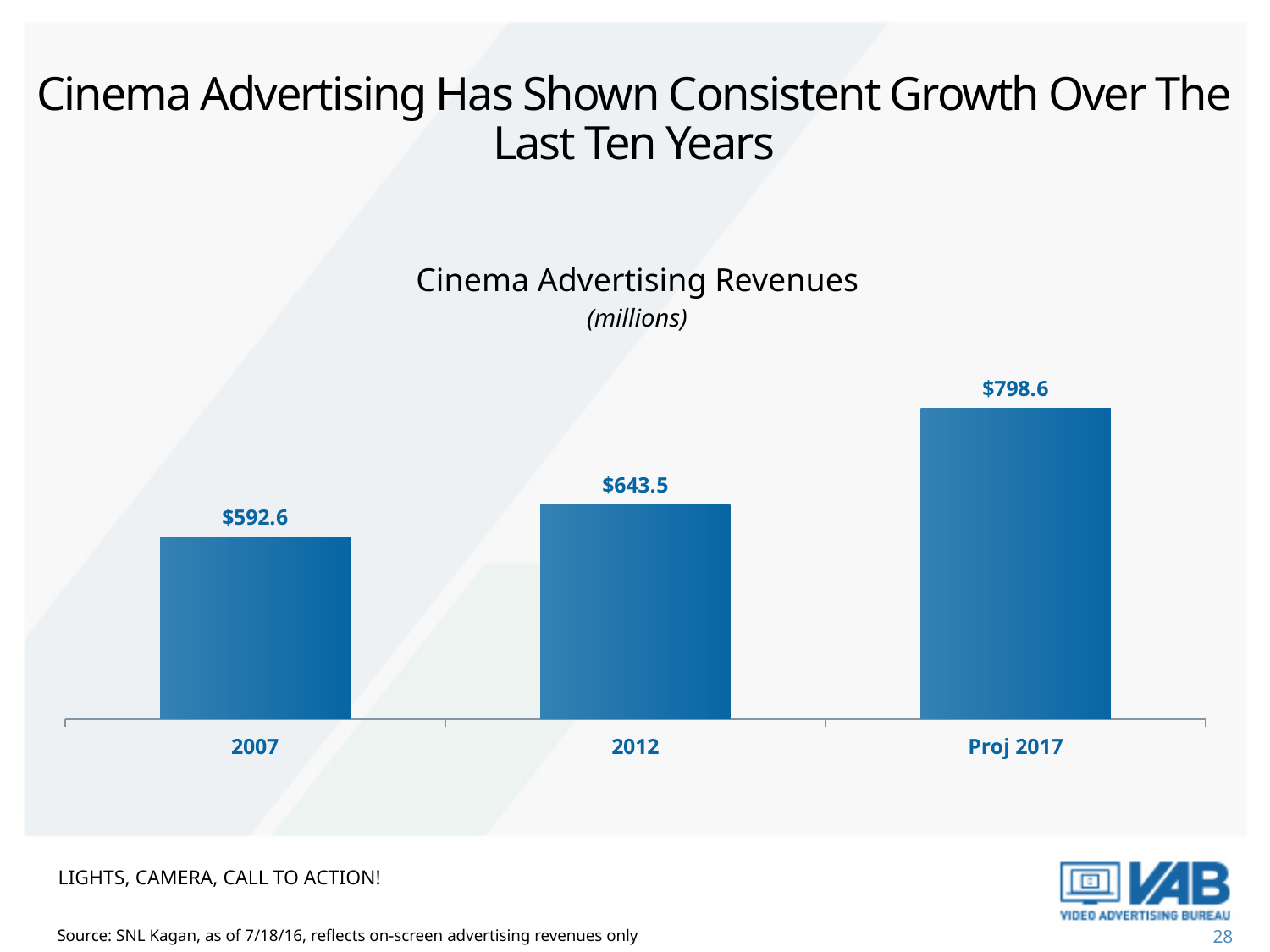
What is the projected cinema advertising revenue for Proj 2017? $798.6 Which has a larger cinema advertising revenue, 2007 or 2012? 2012 What is the difference in cinema advertising revenue between 2012 and 2007? $50.9 What is the difference in cinema advertising revenue between Proj 2017 and 2012? $155.1 Which year has the lowest cinema advertising revenue? 2007 What kind of chart is shown on the slide? Bar chart Do cinema advertising revenues rise or fall from 2007 to Proj 2017? Rise Which year has the highest cinema advertising revenue? Proj 2017 What is the title of the chart? Cinema Advertising Revenues (millions) What is the cinema advertising revenue for 2012? $643.5 What is the cinema advertising revenue for 2007? $592.6 How many years are shown on the chart? 3